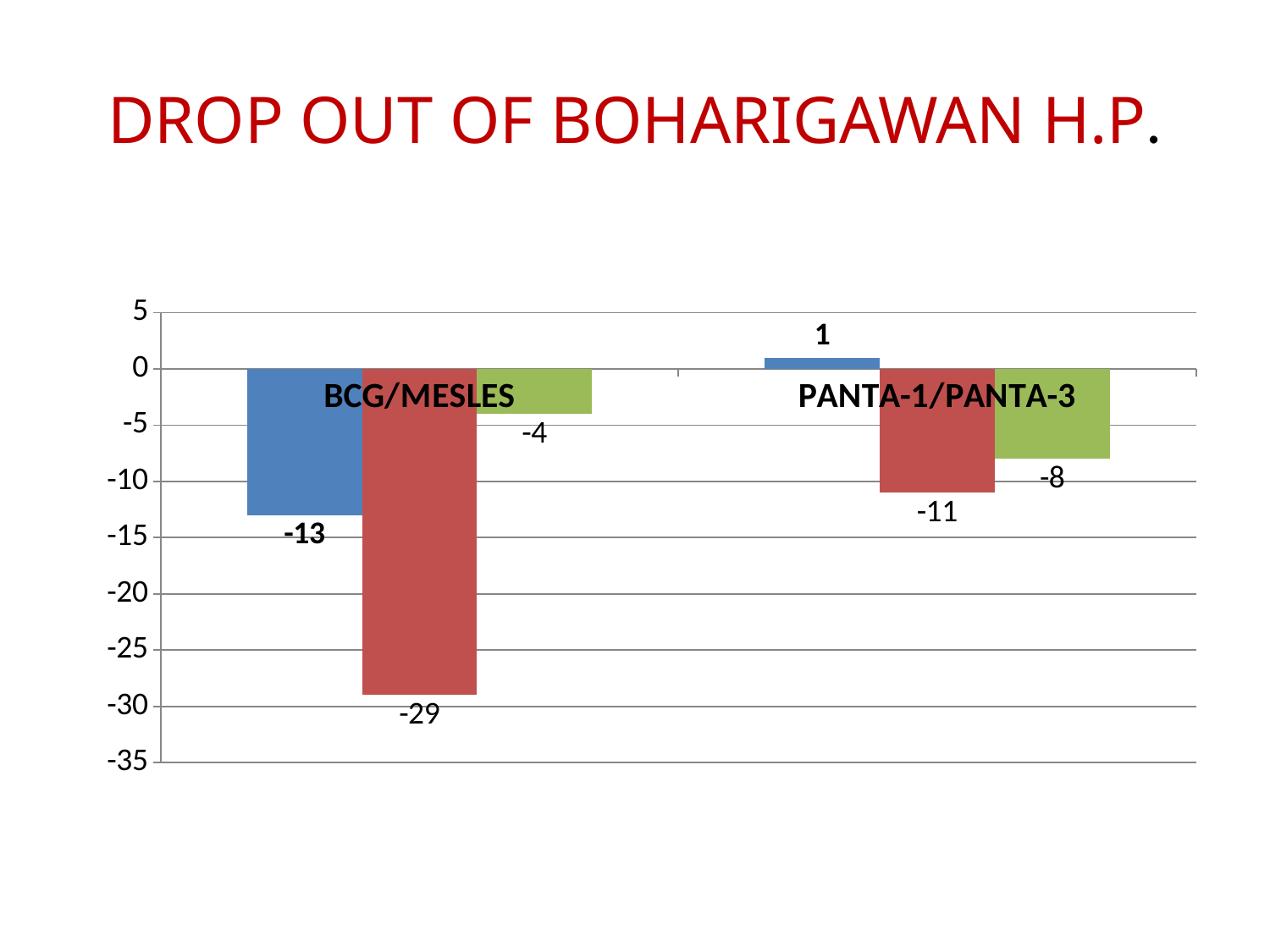
What is the value of the blue bar for PANTA-1/PANTA-3? 1 What is the value of the red bar for BCG/MESLES? -29 What is the value of the green bar for PANTA-1/PANTA-3? -8 What is the value of the blue bar for BCG/MESLES? -13 What is the value of the red bar for PANTA-1/PANTA-3? -11 What is the slide title? DROP OUT OF BOHARIGAWAN H.P. Which bar has the lowest value in the chart? the red bar for BCG/MESLES (-29) What is the value of the green bar for BCG/MESLES? -4 What is the difference between the red bar values for BCG/MESLES and PANTA-1/PANTA-3? 18 What kind of chart is shown on the slide? bar chart How many bars are plotted for the BCG/MESLES category? 3 How many categories are shown on the x axis? 2